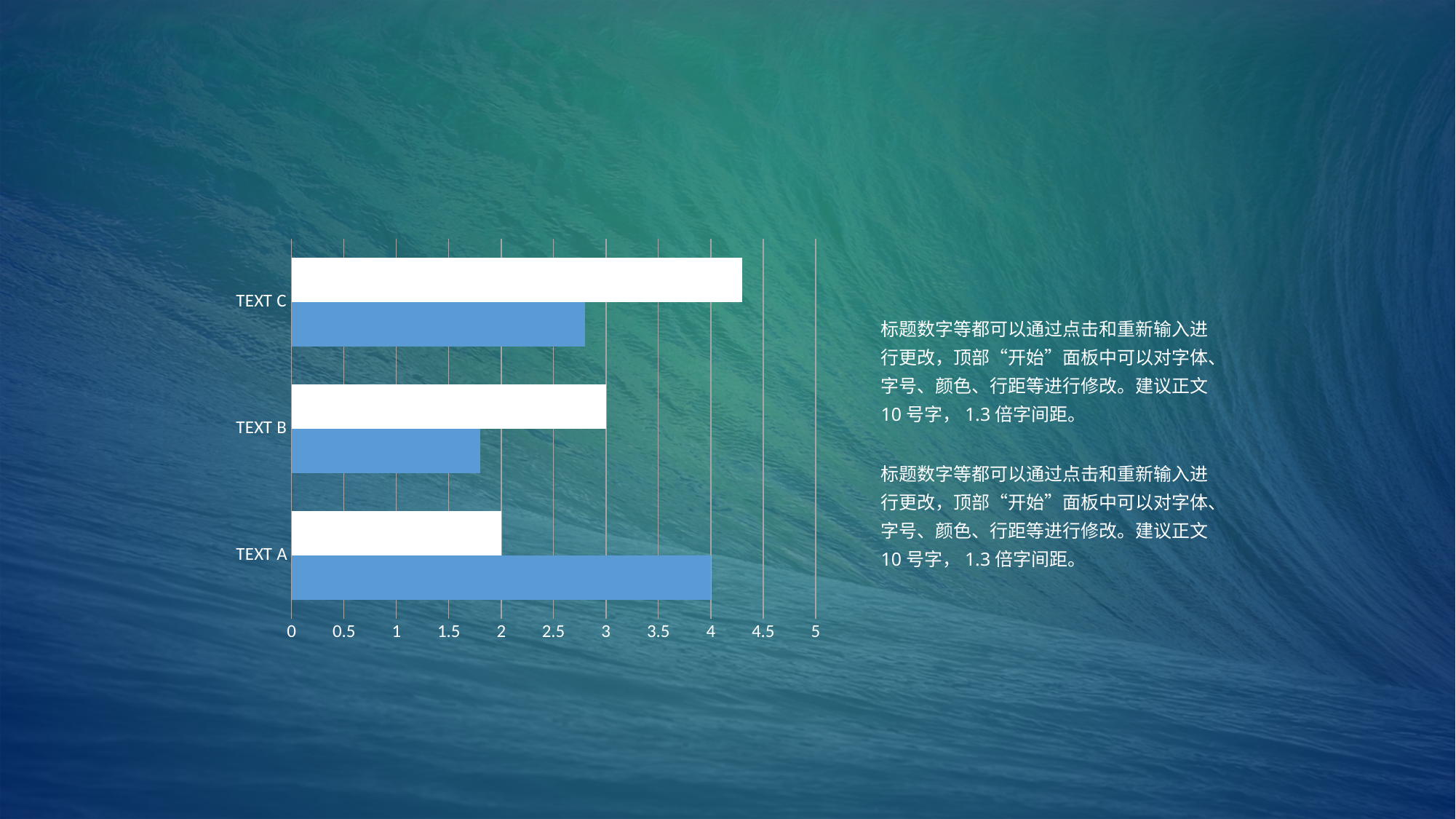
Is the value of the white bar for TEXT C greater or less than 4? greater What is the value of the white bar for TEXT B? 3 Is the value of the blue bar for TEXT B greater or less than 2? less What is the value of the blue bar for TEXT A? 4 Is the value of the blue bar for TEXT C greater or less than 2.5? greater How many categories are shown on the vertical axis of the chart? 3 Which category has the shortest blue bar? TEXT B Which category has the longest white bar? TEXT C For TEXT A, which bar is larger, the white bar or the blue bar? the blue bar What is the value of the white bar for TEXT A? 2 What kind of chart is shown on the slide? bar chart What is the difference between the blue bar and the white bar for TEXT A? 2